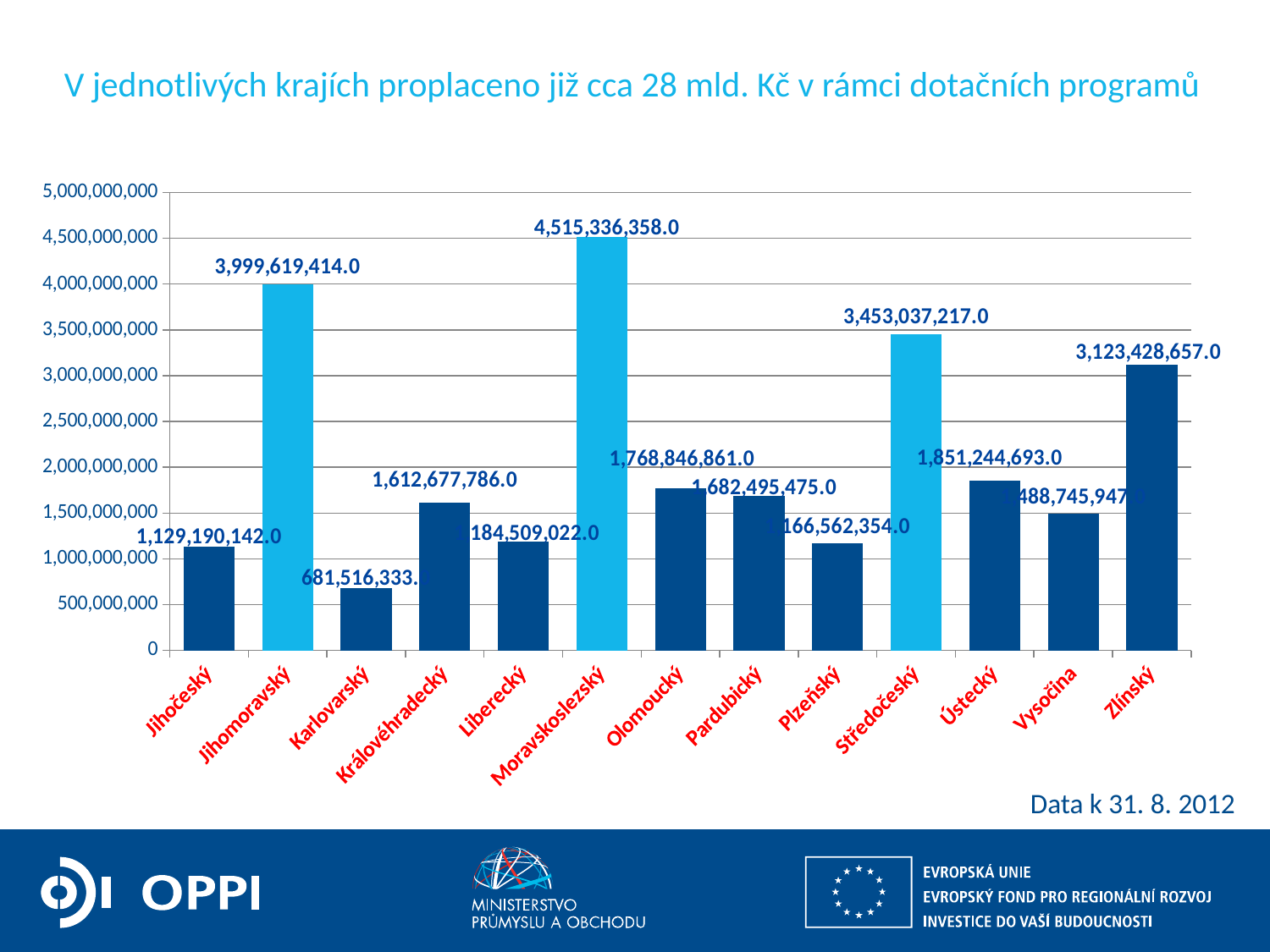
What is the value for Moravskoslezský? 4,515,336,358.0 Which region has the lowest value? Karlovarský Which three regions are drawn with light blue bars instead of dark blue? Jihomoravský, Moravskoslezský, Středočeský What is the difference between the values for Moravskoslezský and Jihomoravský? 515,716,944.0 Which is larger, the value for Jihomoravský or the value for Středočeský? Jihomoravský How many regions are shown on the x axis? 13 Is the value for Karlovarský greater or less than 1,000,000,000? less What kind of chart is shown on the slide? bar chart What is the value for Středočeský? 3,453,037,217.0 What is the value for Jihomoravský? 3,999,619,414.0 Which region has the highest value? Moravskoslezský What is the value for Zlínský? 3,123,428,657.0